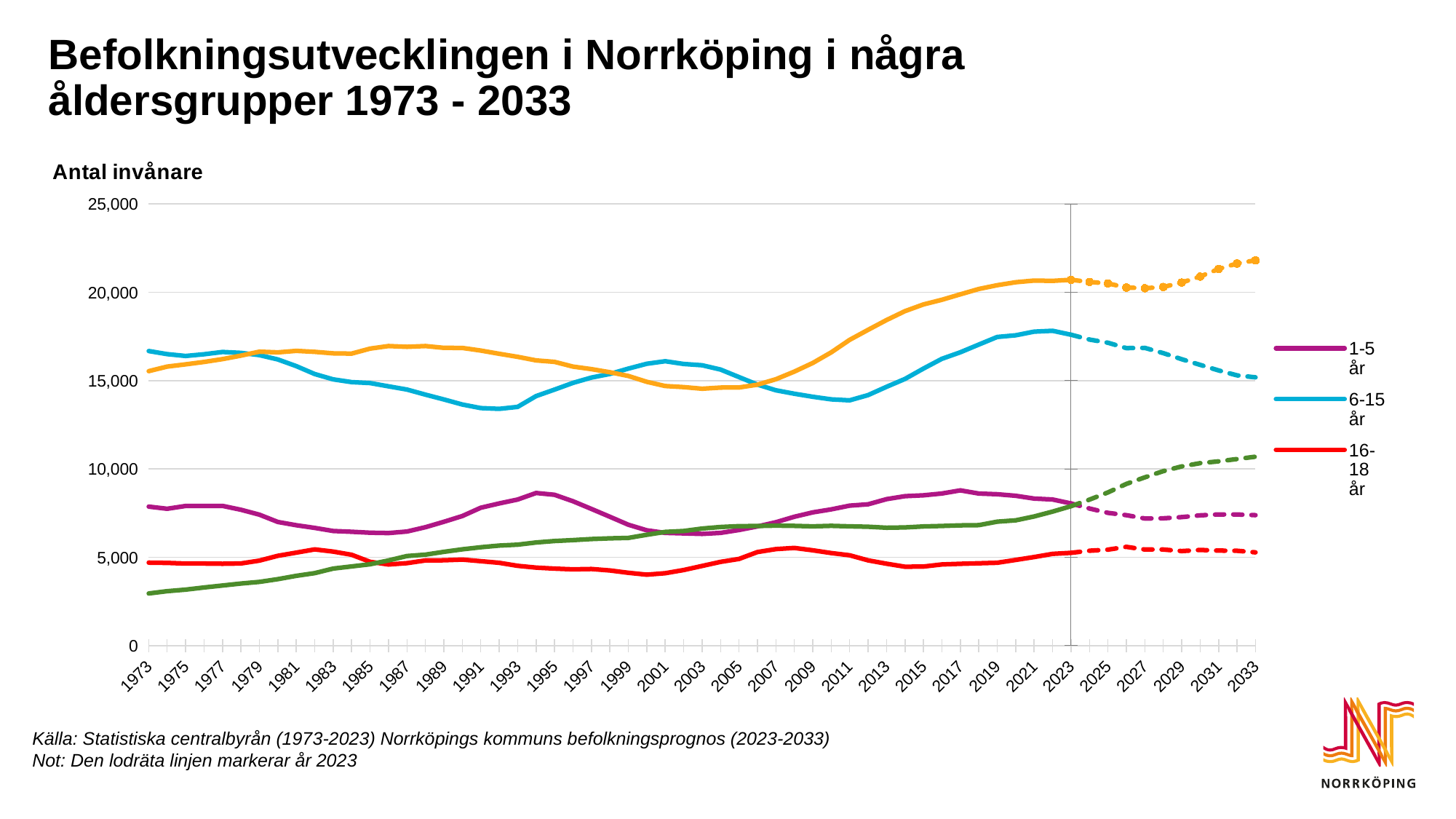
Of the series listed in the legend, which has the lowest value in 2023? 16-18 år Which year does the vertical line in the chart mark? 2023 Is the value for 16-18 år in 2001 greater or less than 5,000? less Is the value for 6-15 år in 2023 greater or less than 15,000? greater Is the value for 1-5 år in 2023 greater or less than 10,000? less What kind of chart is shown on the slide? line chart Does the 6-15 år line rise or fall between 2023 and 2033? fall How many series does the legend list? 3 What is the title of the chart? Befolkningsutvecklingen i Norrköping i några åldersgrupper 1973 - 2033 In 2023, which is larger: the value for 6-15 år or the value for 1-5 år? 6-15 år